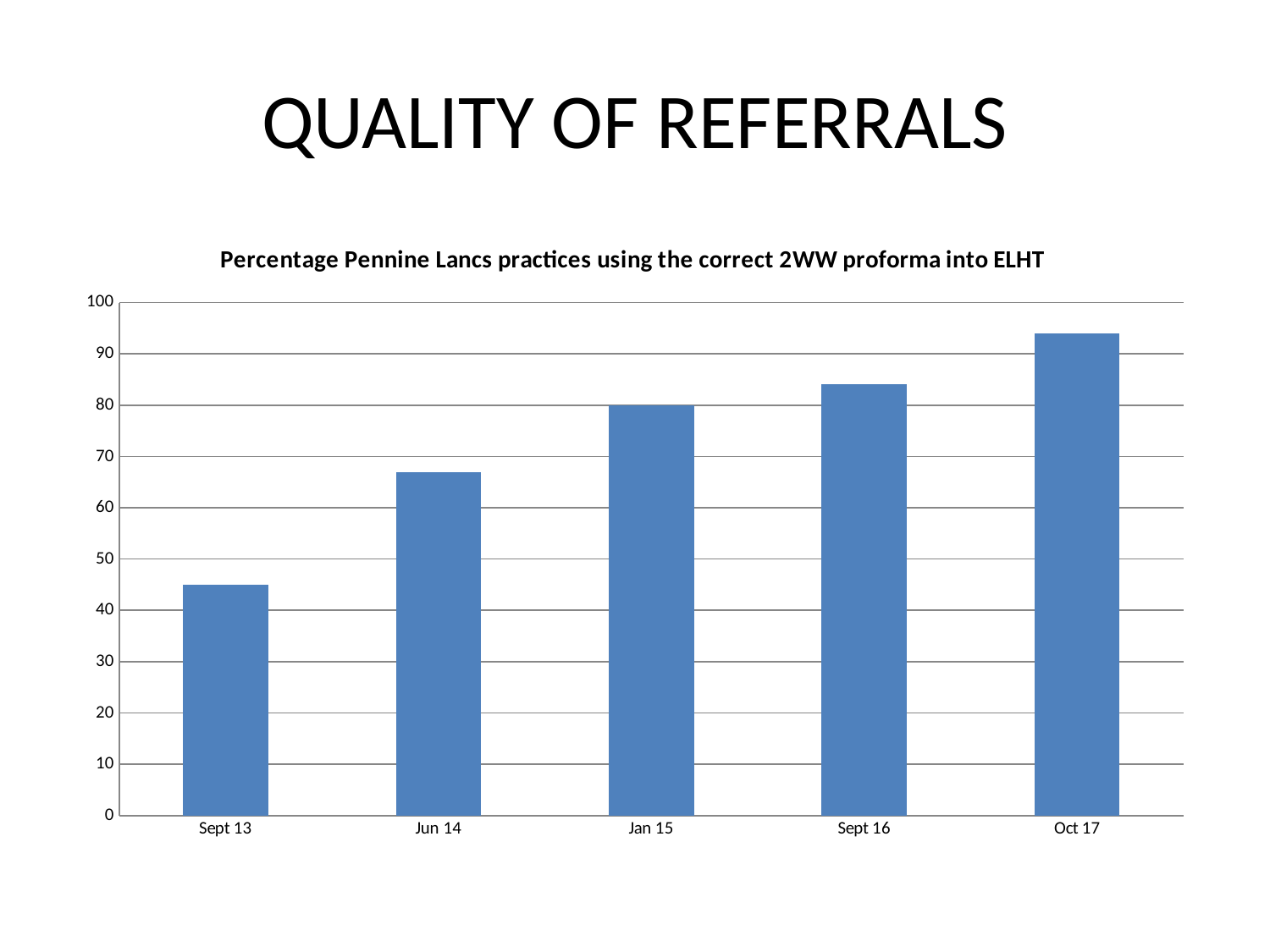
Is the value for Sept 13 greater or less than 50? less What colour are the bars in the chart? blue What is the title of the chart? Percentage Pennine Lancs practices using the correct 2WW proforma into ELHT Which category has the lowest value in the chart? Sept 13 How many categories are shown on the x axis of the chart? 5 Which category has the highest value in the chart? Oct 17 Is the value for Oct 17 greater or less than 90? greater Is the value for Sept 16 greater or less than 80? greater Do the values rise or fall from Sept 13 to Oct 17? rise Which is larger, the value for Jun 14 or the value for Jan 15? Jan 15 What kind of chart is shown on the slide? bar chart